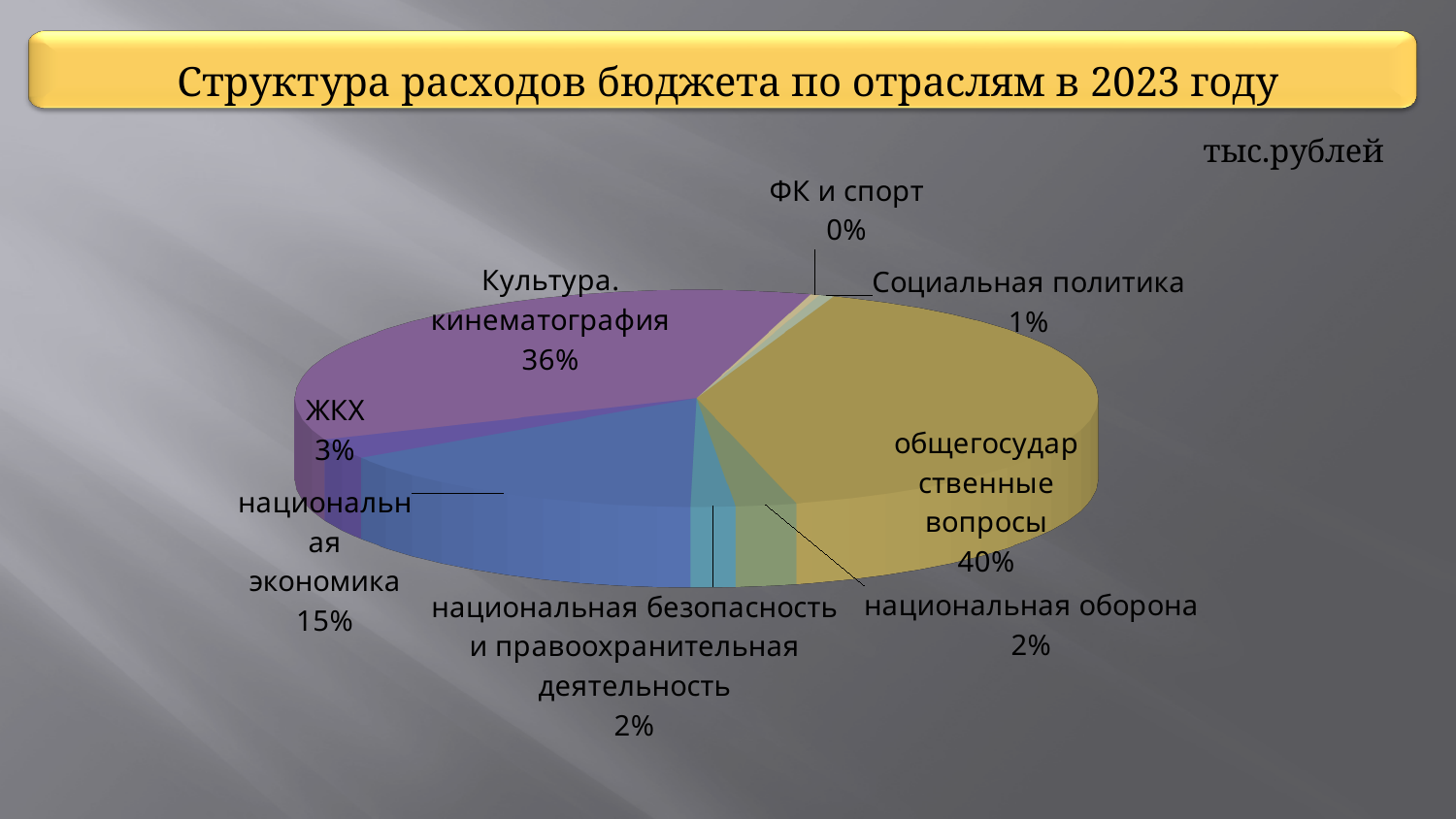
What is the value shown for ФК и спорт? 0% What share of the pie does Культура. кинематография take? 36% Which category has the smallest share of the pie? ФК и спорт What share of the pie does общегосударственные вопросы take? 40% What is the value shown for национальная экономика? 15% How many categories are shown in the pie chart? 8 What type of chart is shown on the slide? pie chart Which category has the largest share of the pie? общегосударственные вопросы What is the value shown for ЖКХ? 3% Which is larger, the share of национальная экономика or the share of ЖКХ? национальная экономика What is the value shown for Социальная политика? 1% What is the difference between the shares of общегосударственные вопросы and Культура. кинематография? 4%